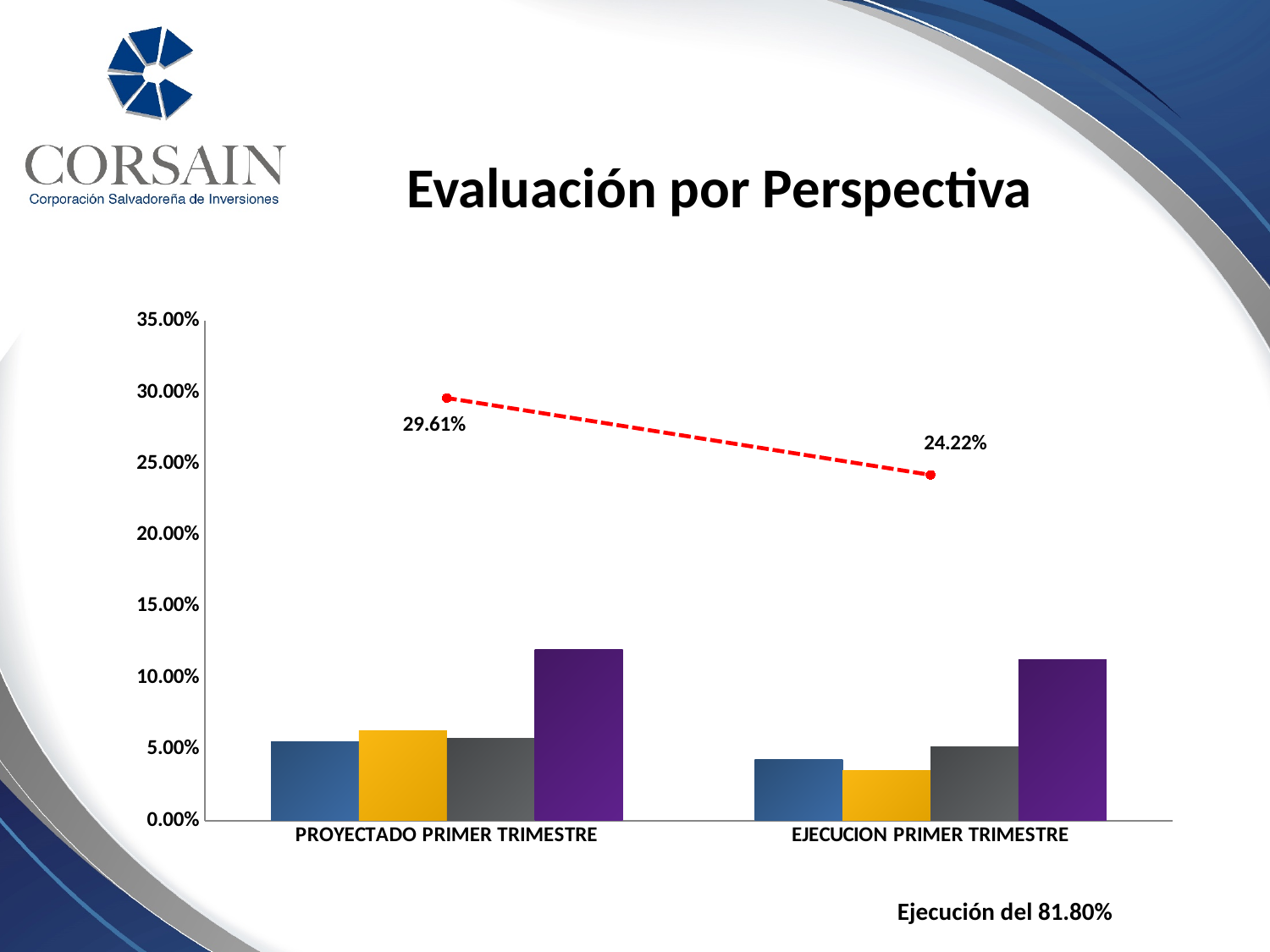
Is the value of the purple bar for PROYECTADO PRIMER TRIMESTRE greater or less than 10.00%? greater Which coloured bar is the tallest in the PROYECTADO PRIMER TRIMESTRE group? purple What is the difference between the red line values at PROYECTADO PRIMER TRIMESTRE and EJECUCION PRIMER TRIMESTRE? 5.39% How many bars are shown for each category? 4 What is the value of the red dashed line at PROYECTADO PRIMER TRIMESTRE? 29.61% Is the value of the yellow bar for EJECUCION PRIMER TRIMESTRE greater or less than 5.00%? less What is the title of the slide containing the chart? Evaluación por Perspectiva Does the red dashed line rise or fall from PROYECTADO PRIMER TRIMESTRE to EJECUCION PRIMER TRIMESTRE? fall Is the red line value higher at PROYECTADO PRIMER TRIMESTRE or at EJECUCION PRIMER TRIMESTRE? PROYECTADO PRIMER TRIMESTRE What execution percentage is stated in the text below the chart? 81.80% How many categories are shown on the x axis? 2 What is the value of the red dashed line at EJECUCION PRIMER TRIMESTRE? 24.22%